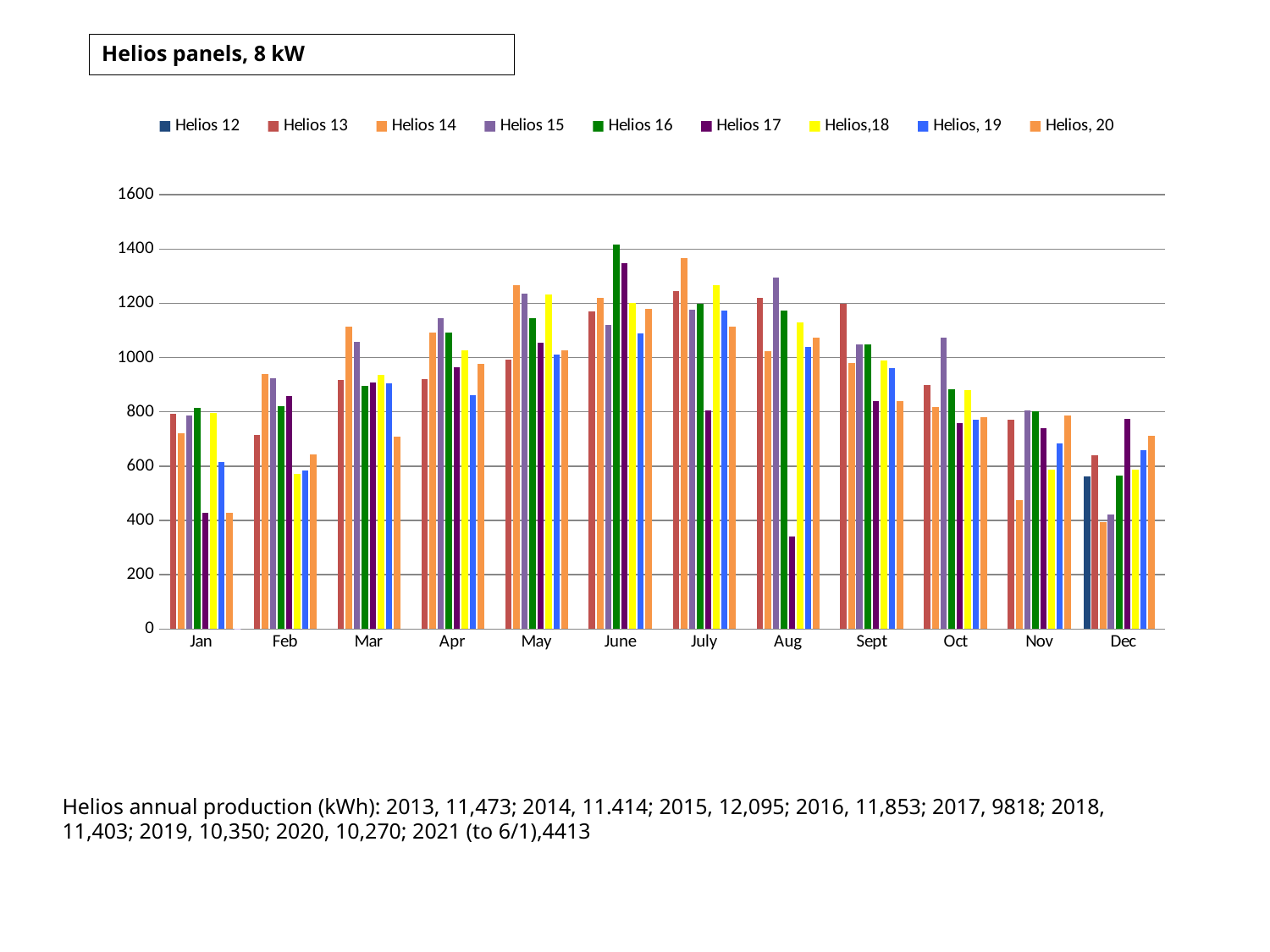
How many series does the legend list? 9 Is the value for Helios 14 in July greater or less than 1200? greater Is the value for Helios, 20 in Mar greater or less than 800? less What is the title shown in the box at the top of the slide? Helios panels, 8 kW What kind of chart is shown on the slide? bar chart Do the values for Helios, 19 rise or fall from Sept to Dec? fall Which is larger for Helios 15: the value in Aug or the value in Nov? Aug Is the value for Helios 13 in Sept greater or less than 1000? greater How many months are shown along the x axis? 12 Which series has the lowest bar in Aug? Helios 17 Which series has the highest bar in June? Helios 16